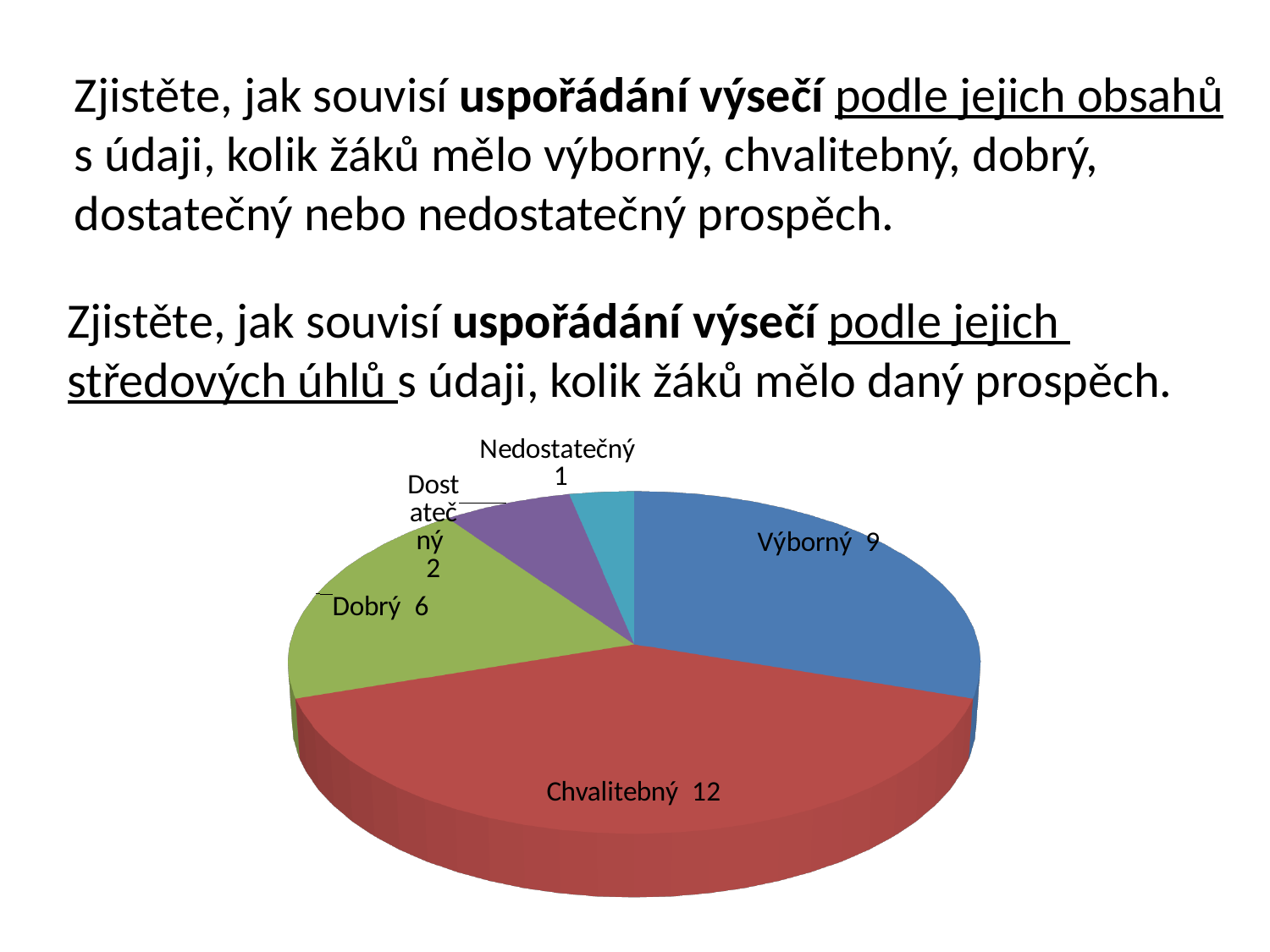
What kind of chart is shown on the slide? pie chart How many students had the grade Výborný according to the pie chart? 9 What value is shown for the Nedostatečný slice? 1 How many slices does the pie chart have? 5 What share of the pie does the Chvalitebný slice represent? 40% Which grade category has the smallest slice of the pie? Nedostatečný Which is larger, the value for Dobrý or the value for Dostatečný? Dobrý What is the difference between the values for Chvalitebný and Výborný? 3 What value is shown for the Dobrý slice? 6 Which grade category has the largest slice of the pie? Chvalitebný What is the total of all the values shown in the pie chart? 30 What value is shown for the Chvalitebný slice? 12